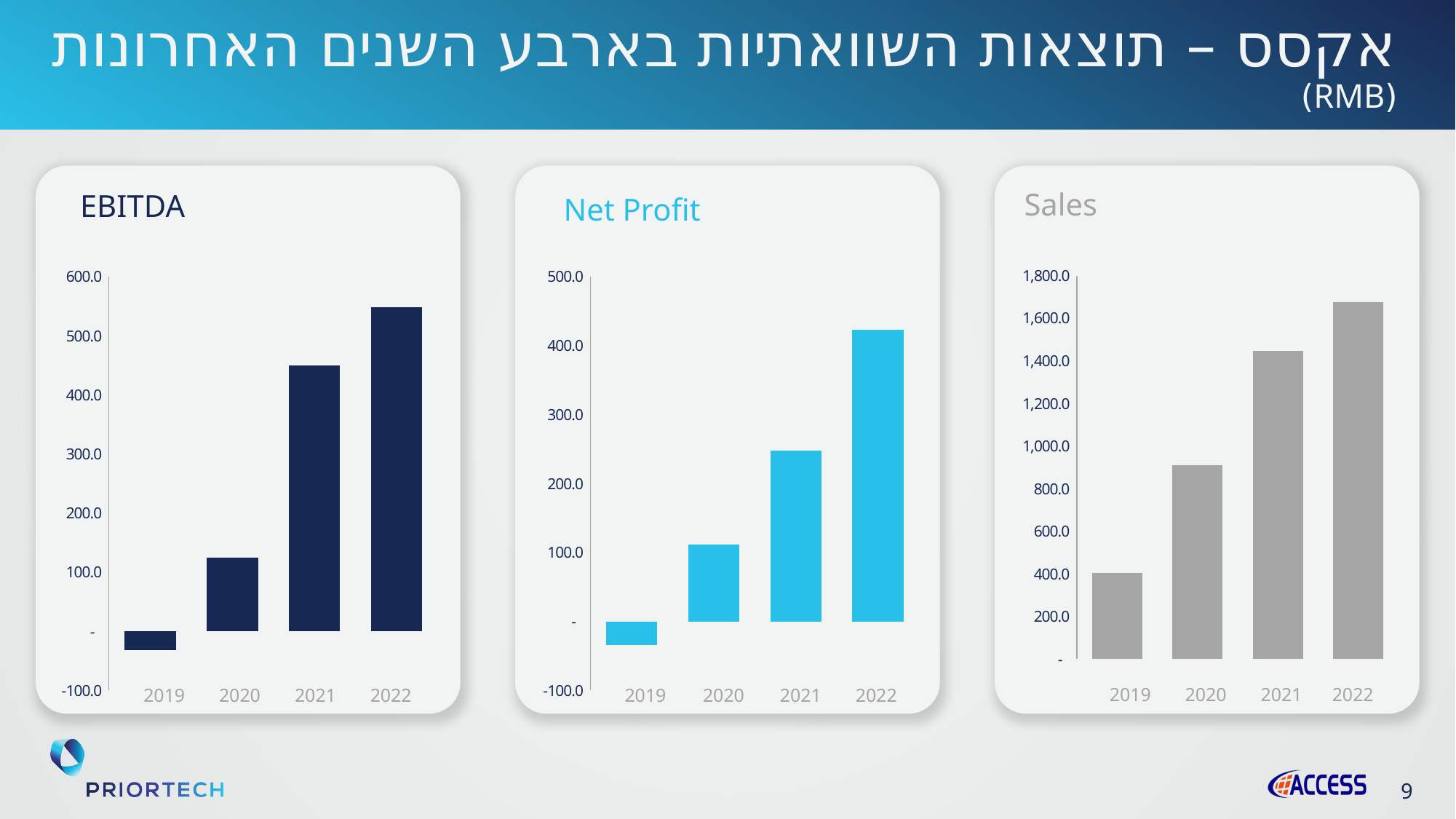
How many years are shown on the x axis of the Sales chart? 4 In the Sales chart, which year has the highest value? 2022 In the EBITDA chart, which year has the highest value? 2022 In the Sales chart, is the value for 2022 greater or less than 1,600.0? greater In the Sales chart, is the value for 2020 greater or less than 1,000.0? less In the Net Profit chart, is the value for 2021 greater or less than 200.0? greater In the Net Profit chart, which year has the lowest value? 2019 In the Sales chart, do the values rise or fall from 2019 to 2022? rise What kind of chart is the EBITDA chart? bar chart In the EBITDA chart, which year has the lowest value? 2019